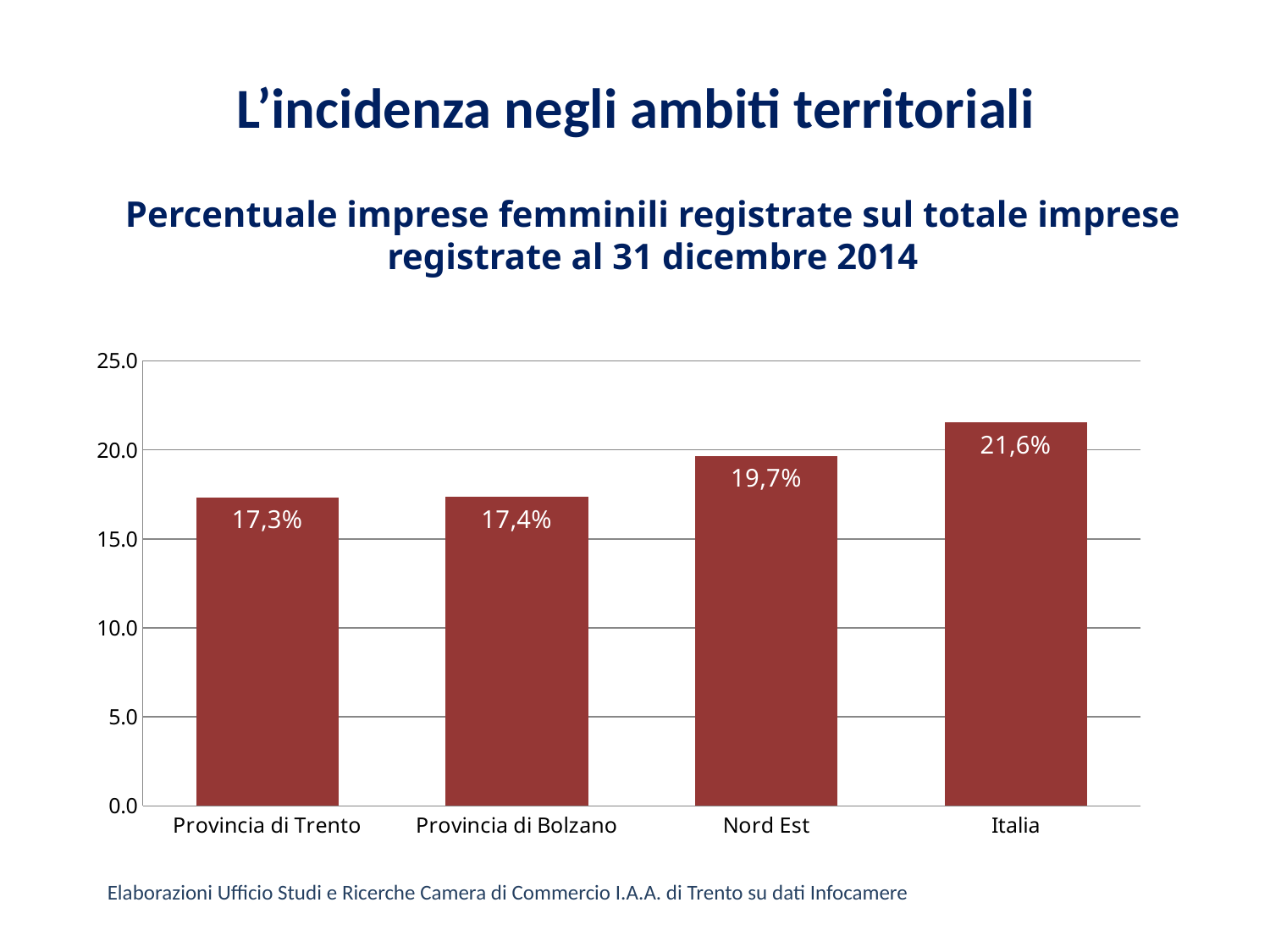
Which is larger, the value for Nord Est or the value for Italia? Italia Do the values rise or fall from left to right along the x axis? rise What kind of chart is shown on the slide? bar chart Which category has the highest value? Italia What is the difference between the values for Italia and Provincia di Trento? 4,3 percentage points What is the value for Nord Est? 19,7% What is the value for Provincia di Trento? 17,3% What is the value for Italia? 21,6% What is the value for Provincia di Bolzano? 17,4% Is the value for Italia greater or less than 20.0? greater How many categories are shown on the x axis? 4 What is the difference between the values for Nord Est and Provincia di Bolzano? 2,3 percentage points